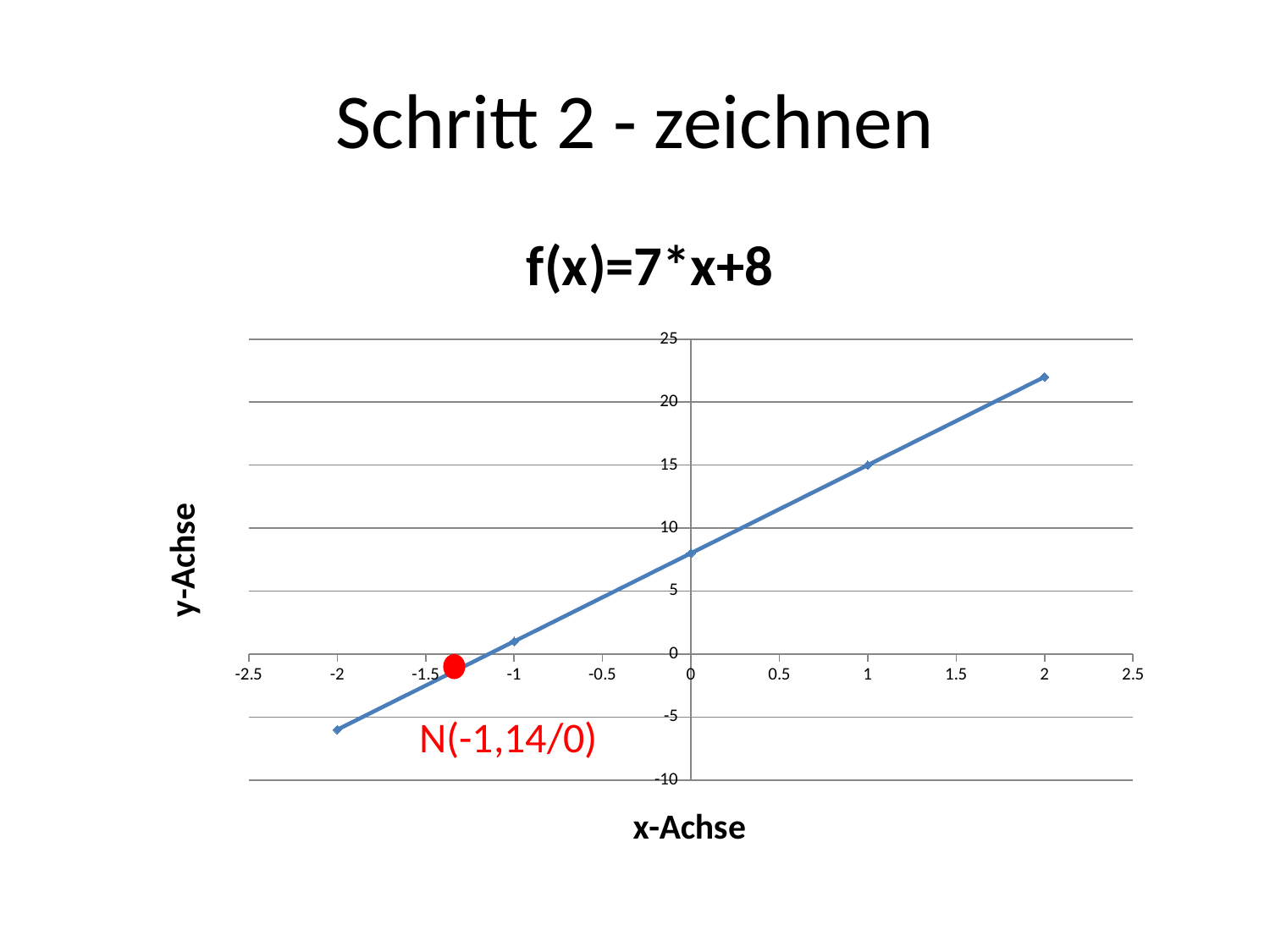
Is the value at x = 2 greater or less than 20? greater What is the y value of the plotted point at x = 1? 15 Do the values rise or fall as x increases along the x axis? rise What kind of chart is shown on the slide? line chart Is the value at x = -1 greater or less than 5? less At which x value is the plotted point lowest? -2 How many data points are plotted on the line? 5 Is the value at x = -2 greater or less than -5? less Which is larger, the value at x = 1 or the value at x = 0? x = 1 At which x value is the plotted point highest? 2 What is the title of the chart? f(x)=7*x+8